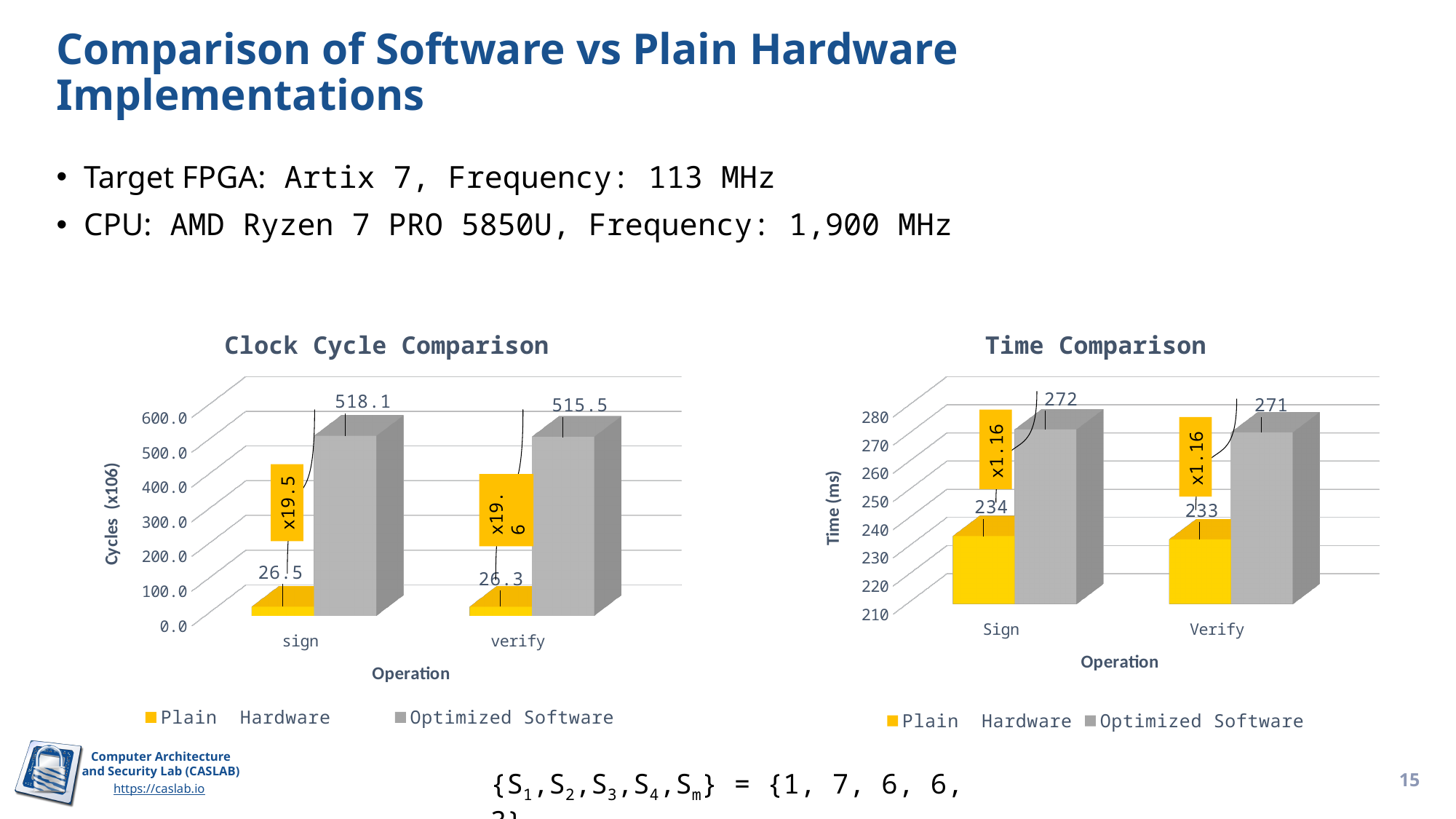
In the Clock Cycle Comparison chart, what is the difference between the Optimized Software and Plain Hardware values for the sign operation? 491.6 What kind of chart is the Time Comparison chart? Bar chart In the Clock Cycle Comparison chart, what is the value for Optimized Software for the sign operation? 518.1 In the Clock Cycle Comparison chart, what is the value for Plain Hardware for the verify operation? 26.3 In the Time Comparison chart, what is the value for Optimized Software for Sign? 272 In the Clock Cycle Comparison chart, which series has the lowest value overall? Plain Hardware How many series does the legend of the Time Comparison chart list? 2 How many operation categories are shown on the x axis of the Clock Cycle Comparison chart? 2 In the Time Comparison chart, what is the value for Plain Hardware for Verify? 233 In the Time Comparison chart, which is larger for Sign: Plain Hardware or Optimized Software? Optimized Software What is the y-axis label of the Time Comparison chart? Time (ms) In the Time Comparison chart, what is the difference between the Optimized Software and Plain Hardware values for Verify? 38